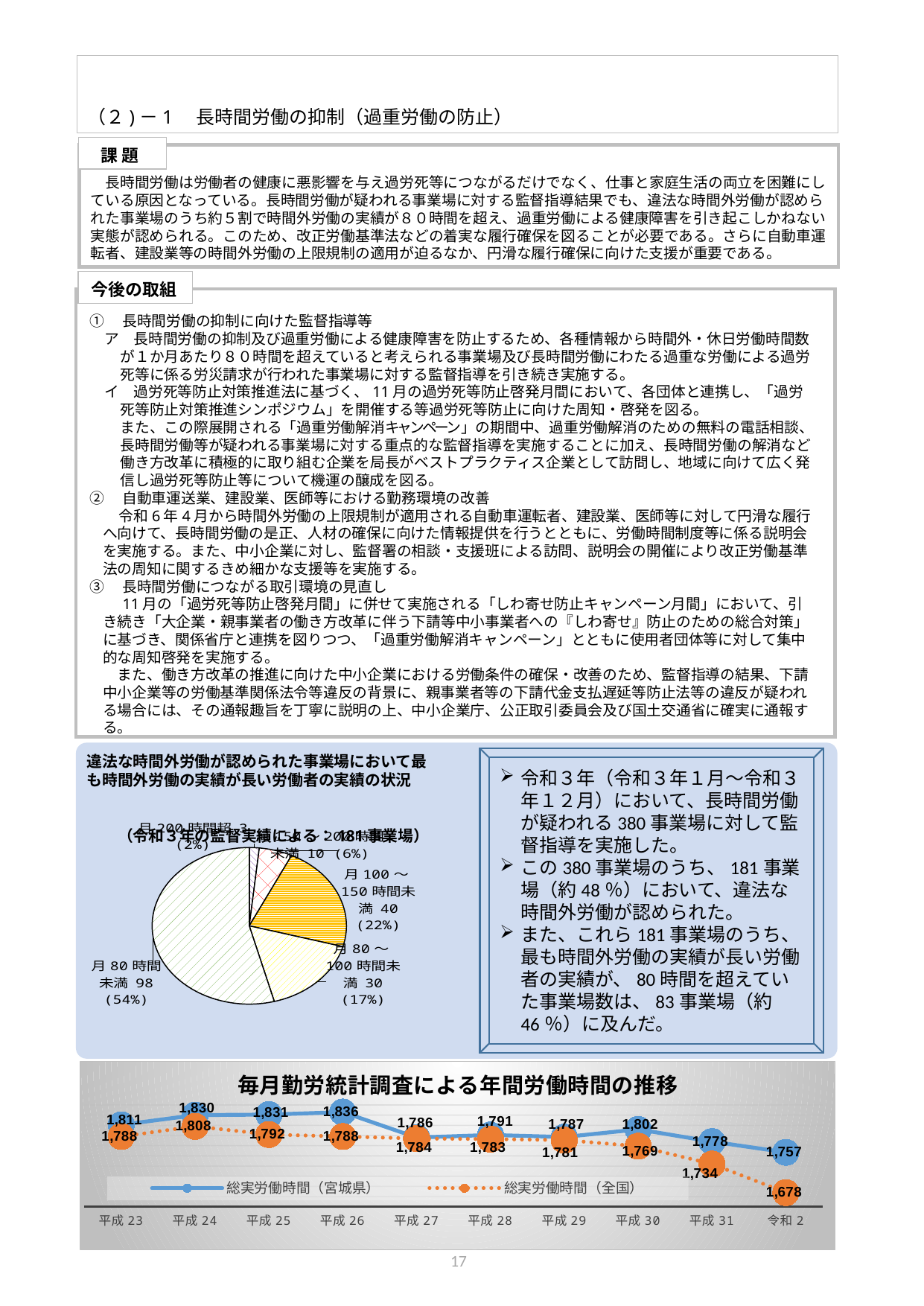
What kind of chart is the chart at the bottom of the slide? line chart In the line chart titled 毎月勤労統計調査による年間労働時間の推移, what is the difference between 総実労働時間（宮城県） and 総実労働時間（全国） in 令和 2? 79 In the line chart titled 毎月勤労統計調査による年間労働時間の推移, which year has the lowest value for 総実労働時間（全国）? 令和 2 In the line chart titled 毎月勤労統計調査による年間労働時間の推移, which year has the highest value for 総実労働時間（宮城県）? 平成 26 In the pie chart on the left, what share of the 181 establishments is 月 80 時間未満? 54% In the line chart titled 毎月勤労統計調査による年間労働時間の推移, what is the value for 総実労働時間（宮城県） in 平成 26? 1,836 In the pie chart on the left, how many establishments are in the 月 100～150 時間未満 category? 40 In the line chart titled 毎月勤労統計調査による年間労働時間の推移, which is larger in 平成 31: 総実労働時間（宮城県） or 総実労働時間（全国）? 総実労働時間（宮城県） In the line chart titled 毎月勤労統計調査による年間労働時間の推移, how many years are plotted on the x axis? 10 In the line chart titled 毎月勤労統計調査による年間労働時間の推移, does 総実労働時間（全国） rise or fall from 平成 30 to 令和 2? fall In the line chart titled 毎月勤労統計調査による年間労働時間の推移, how many series does the legend list? 2 In the line chart titled 毎月勤労統計調査による年間労働時間の推移, what is the value for 総実労働時間（全国） in 令和 2? 1,678